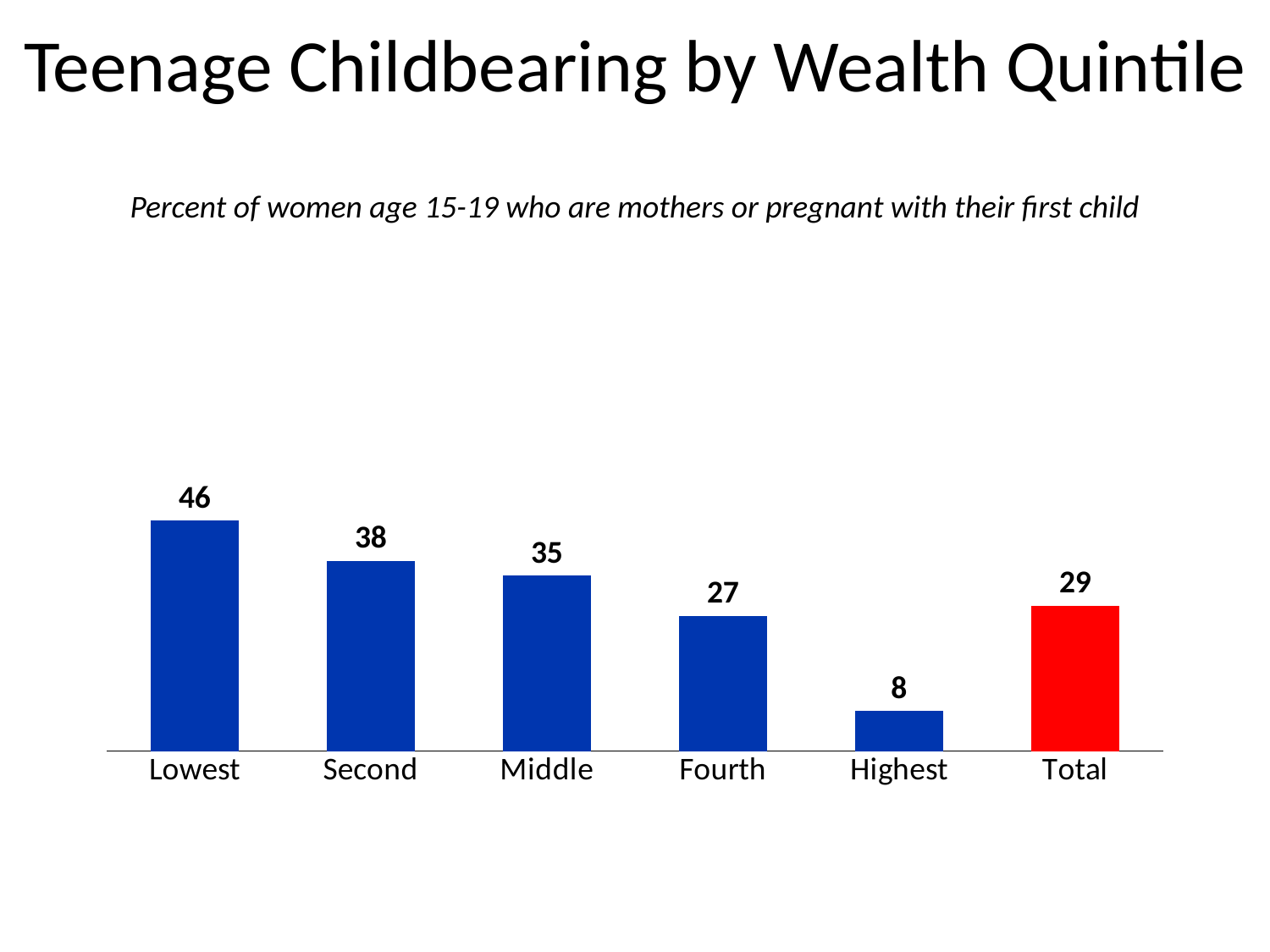
What is the difference between the values for Second and Fourth? 11 Which category has the lowest value? Highest What is the value for the Highest wealth quintile? 8 What is the value for the Total bar? 29 Which is larger, the value for Middle or the value for Total? Middle Which category has the highest value? Lowest Which bar is coloured red? Total What is the value for the Lowest wealth quintile? 46 What kind of chart is shown on the slide? Bar chart What is the difference between the values for Lowest and Highest? 38 How many bars are shown in the chart? 6 What is the value for the Middle wealth quintile? 35